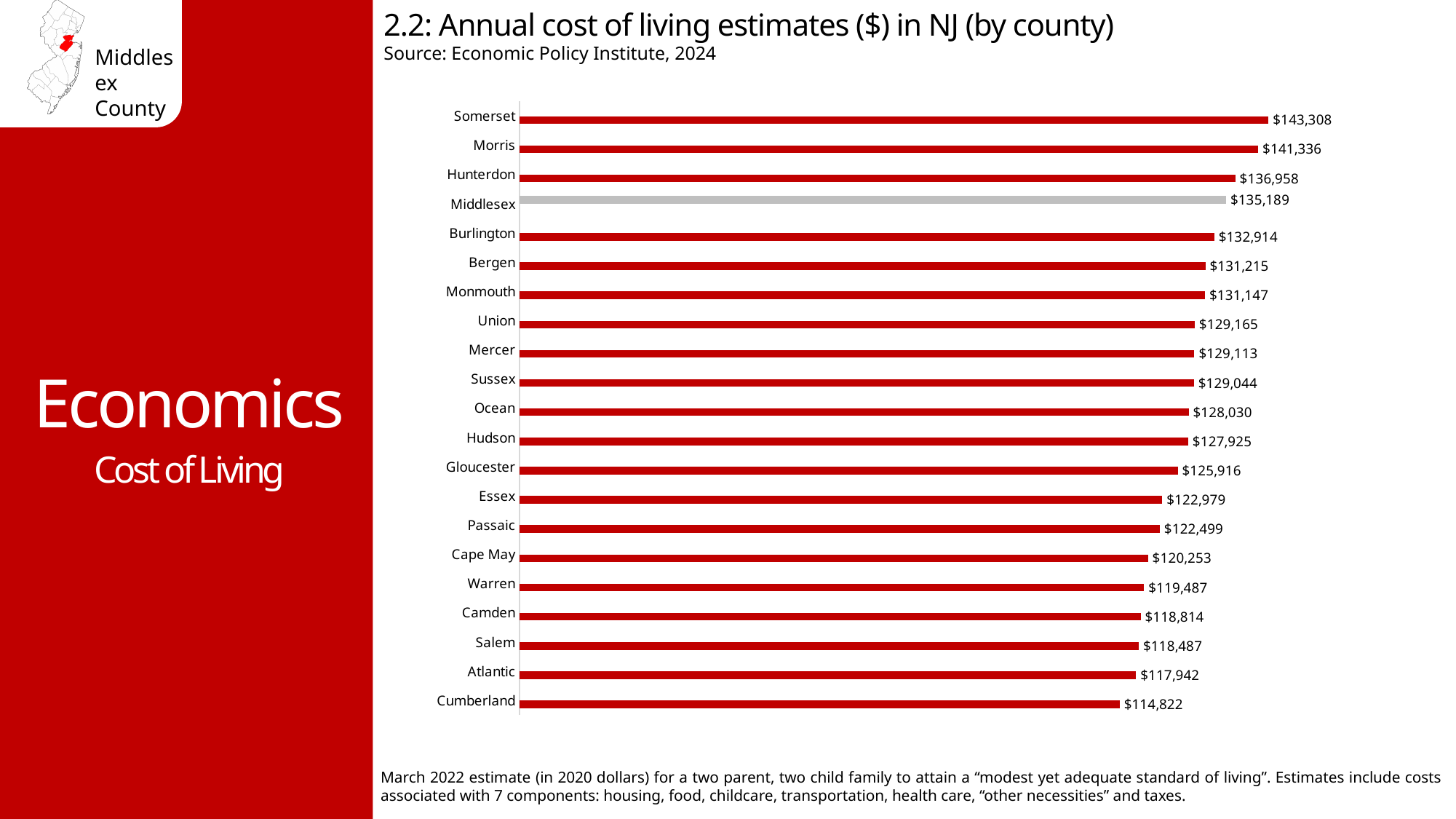
What type of chart is used to show the cost of living estimates? Bar chart How many counties are shown in the chart? 21 What is the annual cost of living estimate for Bergen County? $131,215 What is the annual cost of living estimate for Cape May County? $120,253 What is the annual cost of living estimate for Middlesex County? $135,189 Which county's bar is shown in grey rather than red? Middlesex Which county has a higher cost of living estimate, Essex or Gloucester? Gloucester Which county has the lowest annual cost of living estimate? Cumberland What is the difference between the cost of living estimates for Somerset and Cumberland counties? $28,486 Which county has a higher cost of living estimate, Warren or Camden? Warren How much higher is Hunterdon's cost of living estimate than Middlesex's? $1,769 Which county has the highest annual cost of living estimate? Somerset